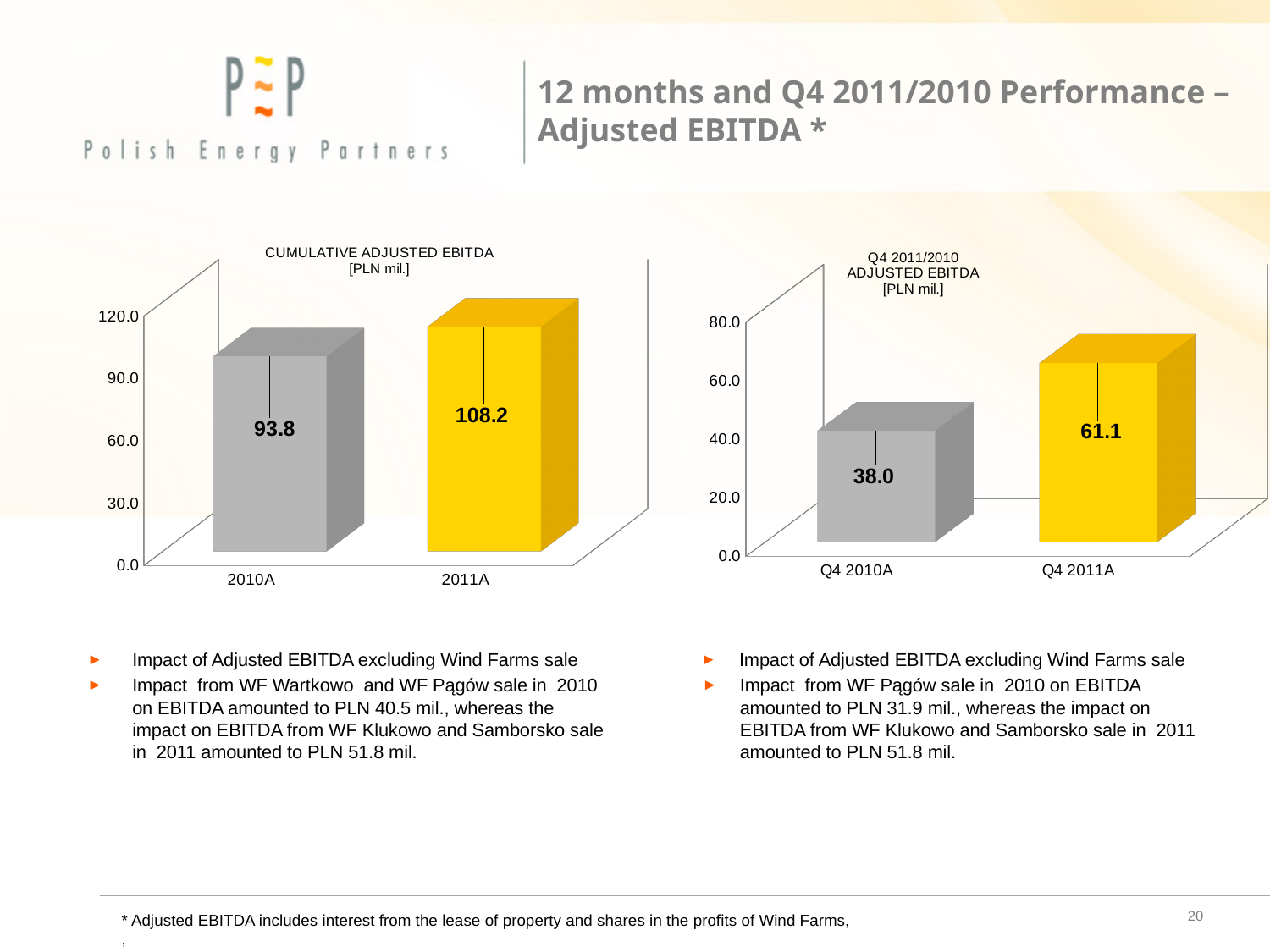
In the Q4 2011/2010 ADJUSTED EBITDA chart, which category has the lowest value? Q4 2010A In the Q4 2011/2010 ADJUSTED EBITDA chart, what is the value for Q4 2010A? 38.0 In the CUMULATIVE ADJUSTED EBITDA chart, which category has the highest value? 2011A In the CUMULATIVE ADJUSTED EBITDA chart, what is the difference between the 2011A and 2010A values? 14.4 In the Q4 2011/2010 ADJUSTED EBITDA chart, what is the value for Q4 2011A? 61.1 In the CUMULATIVE ADJUSTED EBITDA chart, what is the value for 2011A? 108.2 How many categories are shown in the CUMULATIVE ADJUSTED EBITDA chart? 2 In the Q4 2011/2010 ADJUSTED EBITDA chart, which is larger, Q4 2010A or Q4 2011A? Q4 2011A What kind of chart is the Q4 2011/2010 ADJUSTED EBITDA chart? Bar chart In the Q4 2011/2010 ADJUSTED EBITDA chart, what is the difference between the Q4 2011A and Q4 2010A values? 23.1 In the CUMULATIVE ADJUSTED EBITDA chart, what unit is given in the title? PLN mil. In the CUMULATIVE ADJUSTED EBITDA chart, what is the value for 2010A? 93.8